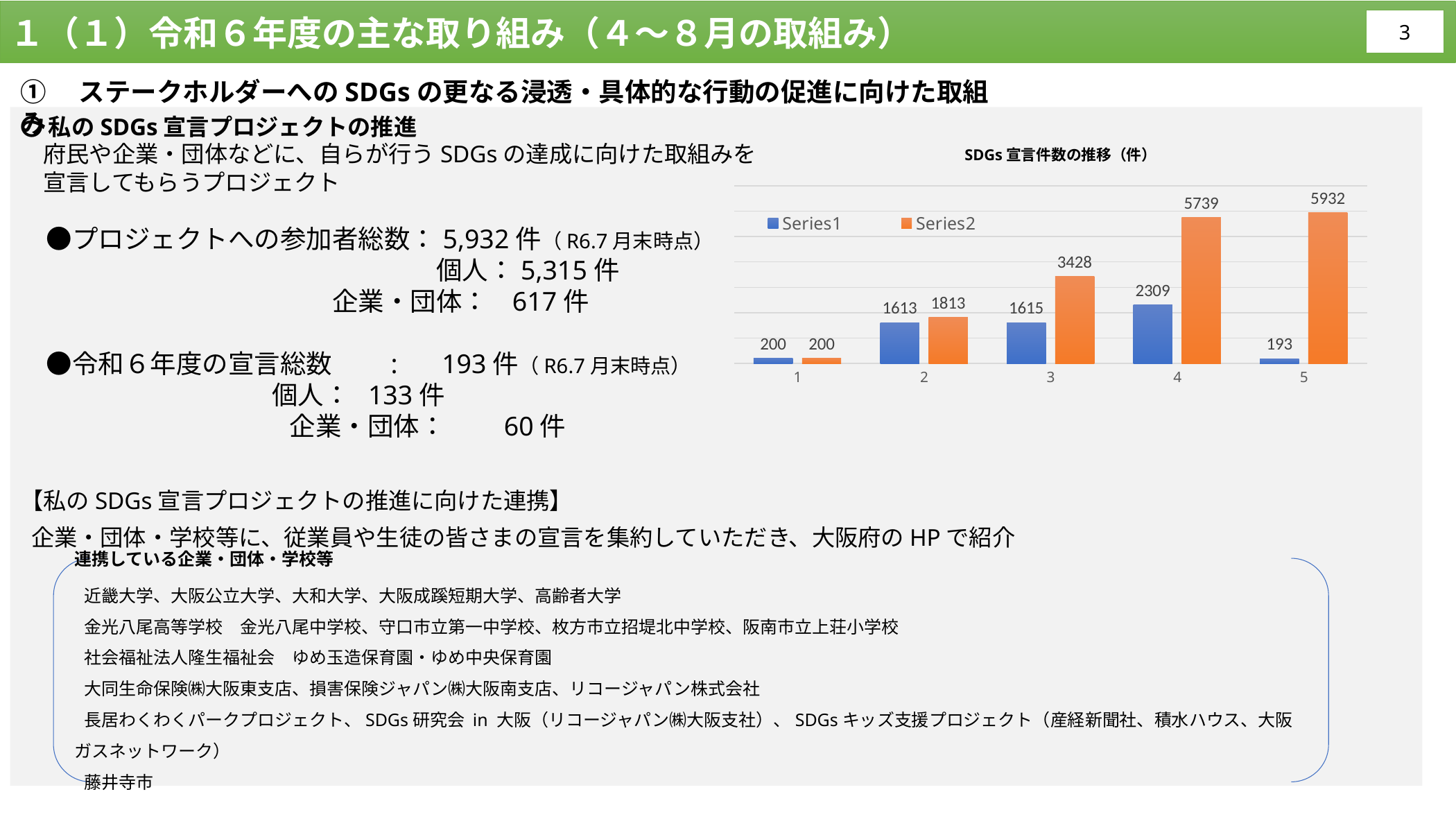
How many series does the chart's legend list? 2 What is the difference between Series2 and Series1 for category 4? 3430 What is the value of Series2 for category 3? 3428 Which category has the highest Series2 value? 5 Does the Series2 value rise or fall from category 1 to category 5? rise What is the value of Series1 for category 5? 193 What is the value of Series2 for category 4? 5739 Which category has the lowest Series1 value? 5 How many categories are shown on the x axis of the chart? 5 Which is larger for category 2: Series1 or Series2? Series2 What is the title of the chart on the slide? SDGs 宣言件数の推移（件） What kind of chart is shown on the slide? bar chart